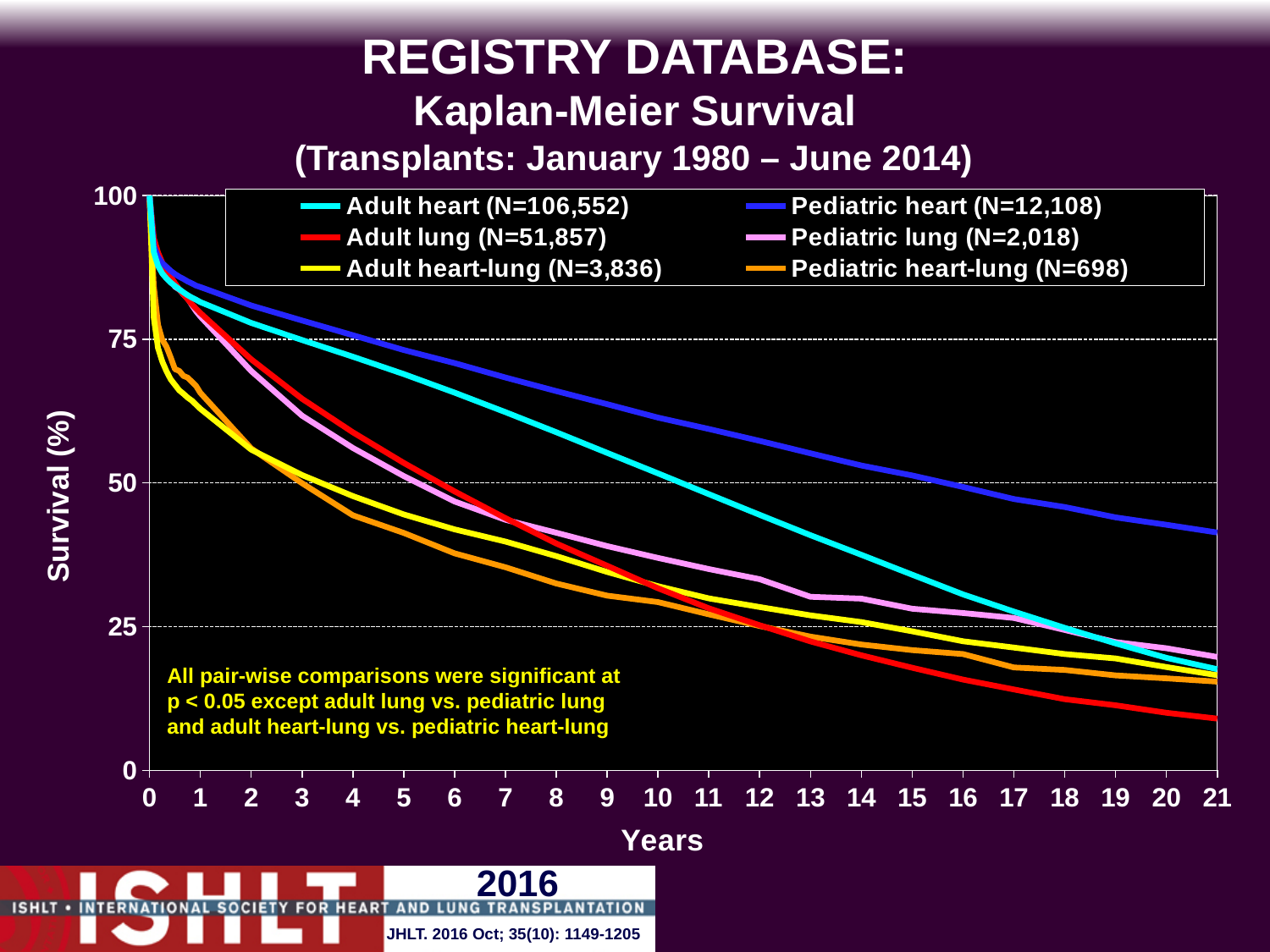
Is the survival for Adult heart at 10 years greater or less than 25? greater Is the survival for Pediatric heart at 21 years greater or less than 50? less What kind of chart is shown on the slide? Line chart What is the N shown in the legend for Adult heart? 106,552 What is the N shown in the legend for Pediatric heart-lung? 698 Which series has the highest survival at 21 years? Pediatric heart Which series has the lowest survival at 21 years? Adult lung How many series does the legend list? 6 Is the survival for Adult lung at 21 years greater or less than 25? less Do the survival curves rise or fall as years increase? Fall At 15 years, which has higher survival: Pediatric heart or Adult heart? Pediatric heart At 10 years, which has higher survival: Adult heart or Adult lung? Adult heart